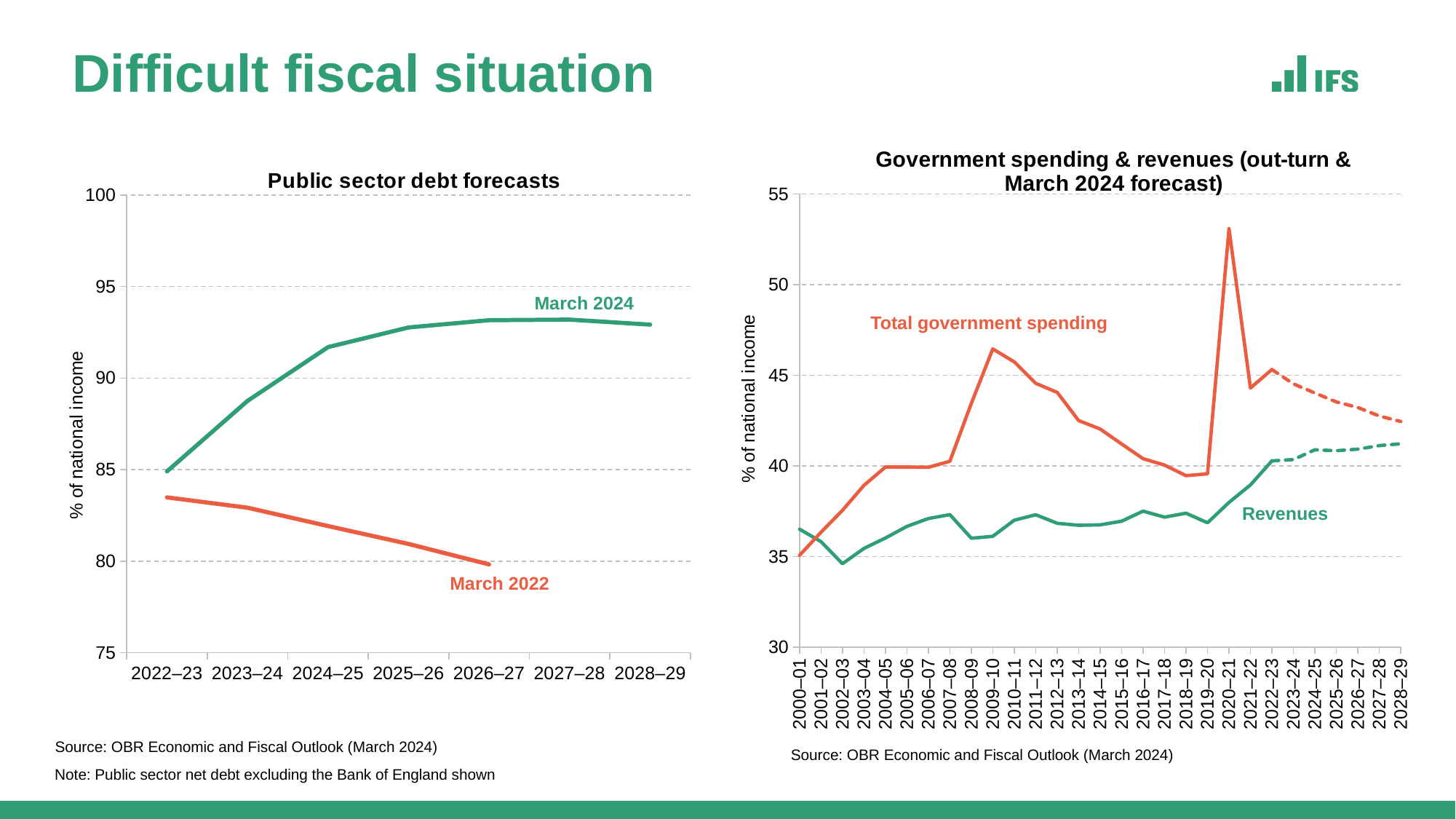
In the 'Government spending & revenues' chart, in which year is Revenues at its lowest? 2002–03 In the 'Public sector debt forecasts' chart, is the March 2024 value for 2022–23 greater or less than 90? less In the 'Public sector debt forecasts' chart, which series has the higher value in 2024–25, March 2024 or March 2022? March 2024 In the 'Public sector debt forecasts' chart, does the March 2024 line rise or fall from 2022–23 to 2028–29? Rise In the 'Public sector debt forecasts' chart, does the March 2022 line rise or fall from 2022–23 to 2026–27? Fall What is the title of the chart on the right of the slide? Government spending & revenues (out-turn & March 2024 forecast) In the 'Public sector debt forecasts' chart, how many series are plotted? 2 In the 'Government spending & revenues' chart, is the Total government spending value for 2020–21 greater or less than 50? greater What kind of chart is the 'Public sector debt forecasts' chart? Line chart How many years are shown on the x axis of the 'Public sector debt forecasts' chart? 7 In the 'Government spending & revenues' chart, in which year does Total government spending reach its highest value? 2020–21 In the 'Public sector debt forecasts' chart, is the March 2024 value for 2028–29 greater or less than 90? greater